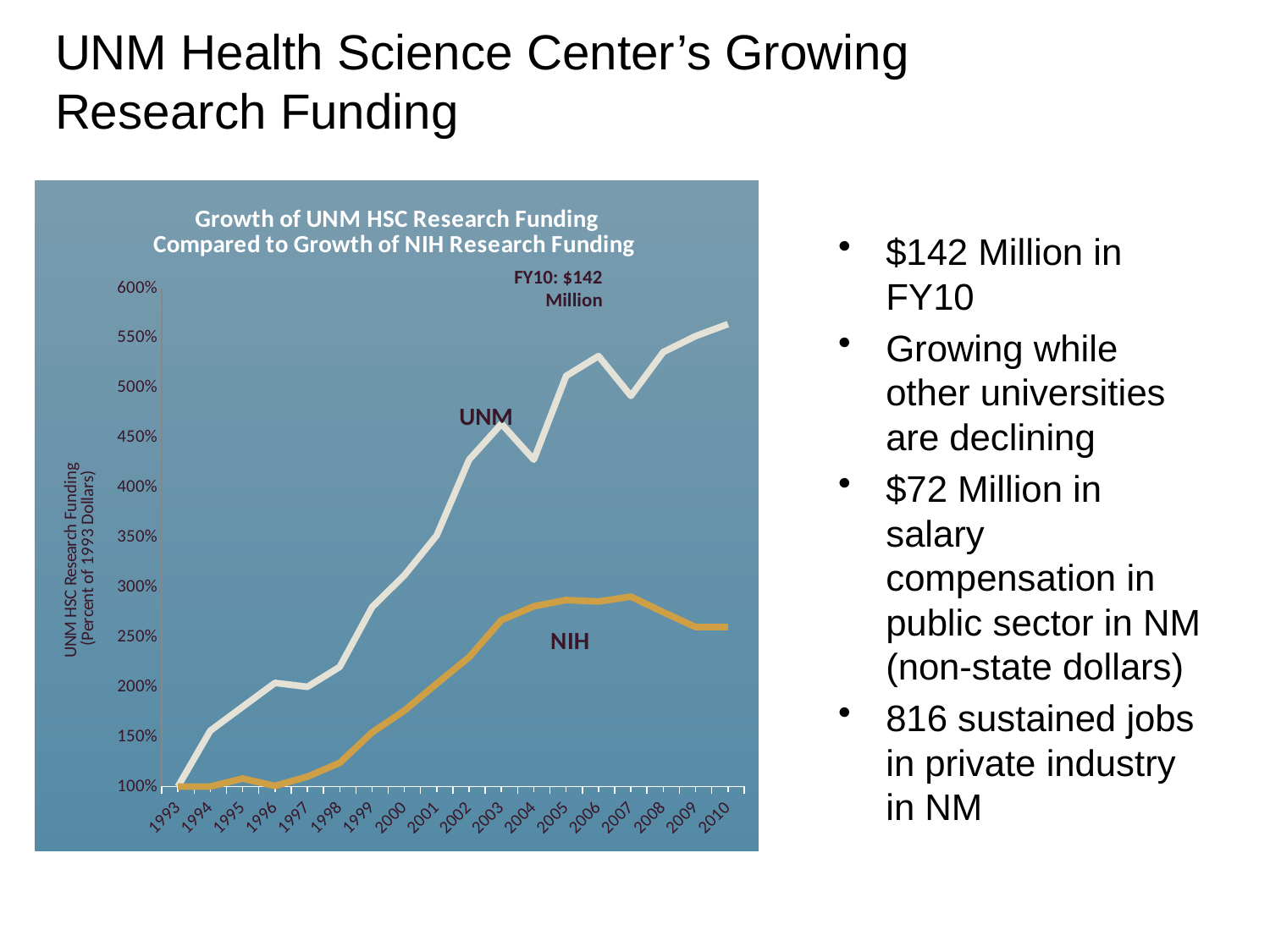
What is the title of the chart? Growth of UNM HSC Research Funding Compared to Growth of NIH Research Funding How many years are shown along the x axis of the chart? 18 Is the NIH value for 2010 greater or less than 300%? less Is the UNM value for 2010 greater or less than 500%? greater What kind of chart is shown on the slide? line chart In 2010, which line is higher, UNM or NIH? UNM In which year does the UNM line reach its highest value? 2010 Is the NIH value for 1999 greater or less than 200%? less What is the value of the UNM line in 1993? 100% Does the UNM line generally rise or fall from 1993 to 2010? rise How many data series are plotted in the chart? 2 Does the NIH line rise or fall from 2007 to 2010? fall